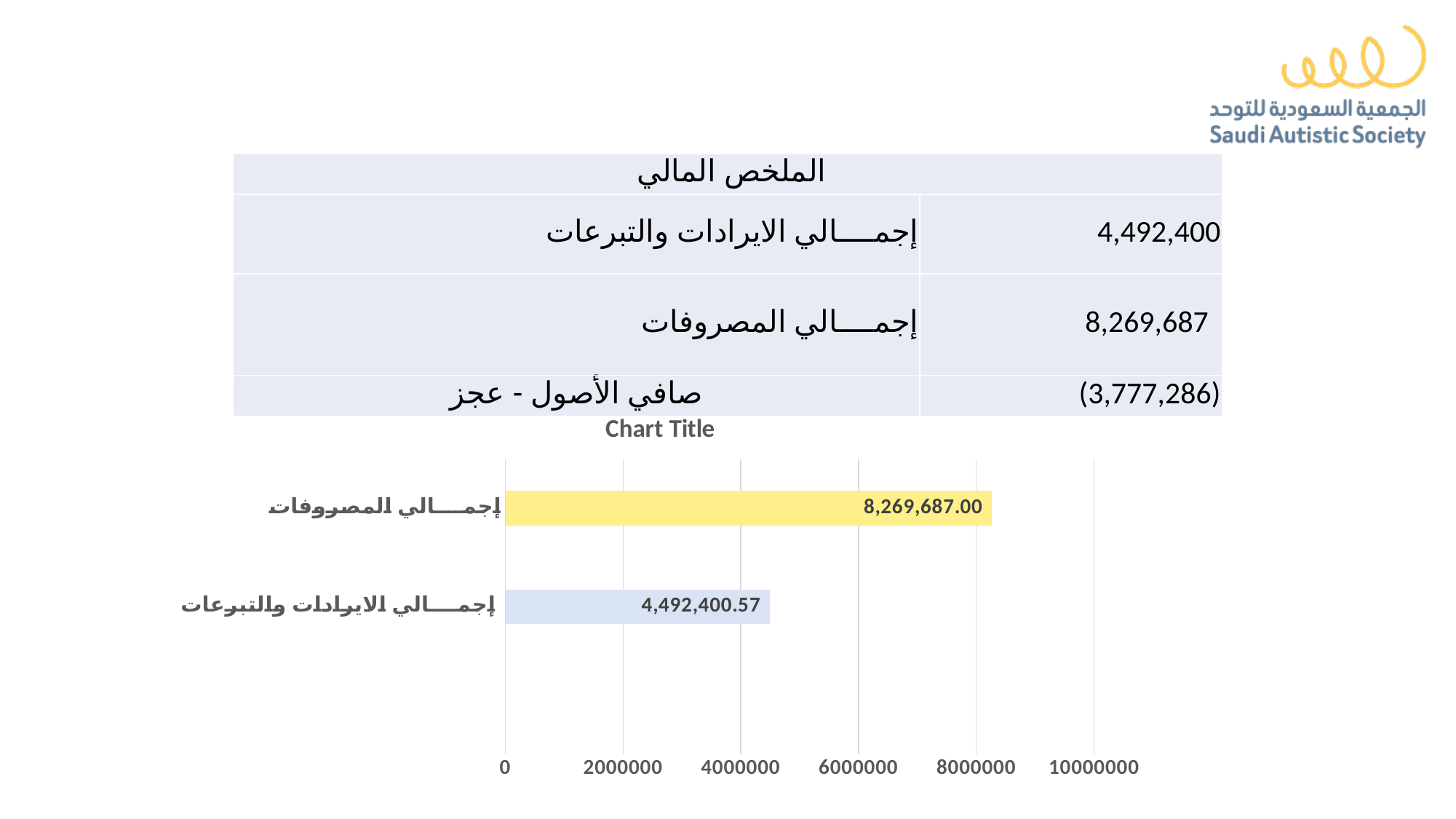
Which category has the lowest value in the chart? إجمالي الايرادات والتبرعات What is the value shown for إجمالي المصروفات in the chart? 8,269,687.00 Is the value for إجمالي المصروفات greater or less than 6000000? greater What is the highest value labelled on the chart's horizontal axis? 10000000 What is the title of the chart? Chart Title Which is larger in the chart: إجمالي المصروفات or إجمالي الايرادات والتبرعات? إجمالي المصروفات Is the value for إجمالي الايرادات والتبرعات greater or less than 6000000? less Which category has the highest value in the chart? إجمالي المصروفات What is the value shown for إجمالي الايرادات والتبرعات in the chart? 4,492,400.57 What kind of chart is shown on the slide? bar chart How many categories are plotted in the chart? 2 What is the difference between the value for إجمالي المصروفات and the value for إجمالي الايرادات والتبرعات in the chart? 3,777,286.43